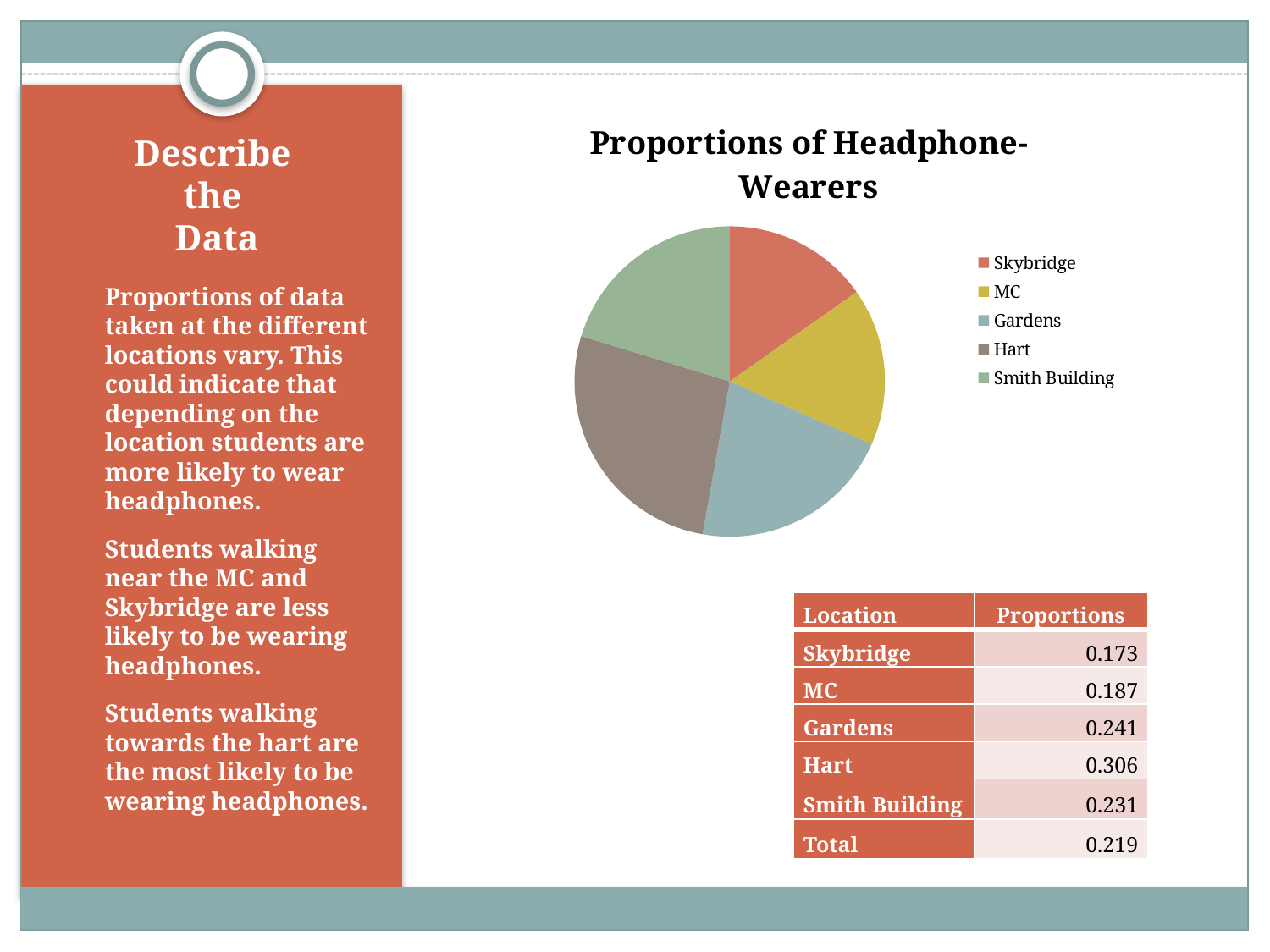
What is the title of the pie chart? Proportions of Headphone-Wearers What kind of chart is shown on the slide? pie chart According to the table, what is the proportion of headphone-wearers at the Smith Building? 0.231 Using the table values, what is the difference between the proportions for Gardens and MC? 0.054 Which slice is larger in the pie chart, Hart or Gardens? Hart Using the table values, what is the difference between the proportions for Hart and Skybridge? 0.133 Which location has the smallest slice in the pie chart? Skybridge According to the table, what is the proportion of headphone-wearers at Hart? 0.306 According to the table, what is the proportion of headphone-wearers at Skybridge? 0.173 Which location has the largest slice in the pie chart? Hart How many entries does the pie chart's legend list? 5 How many slices does the pie chart have? 5